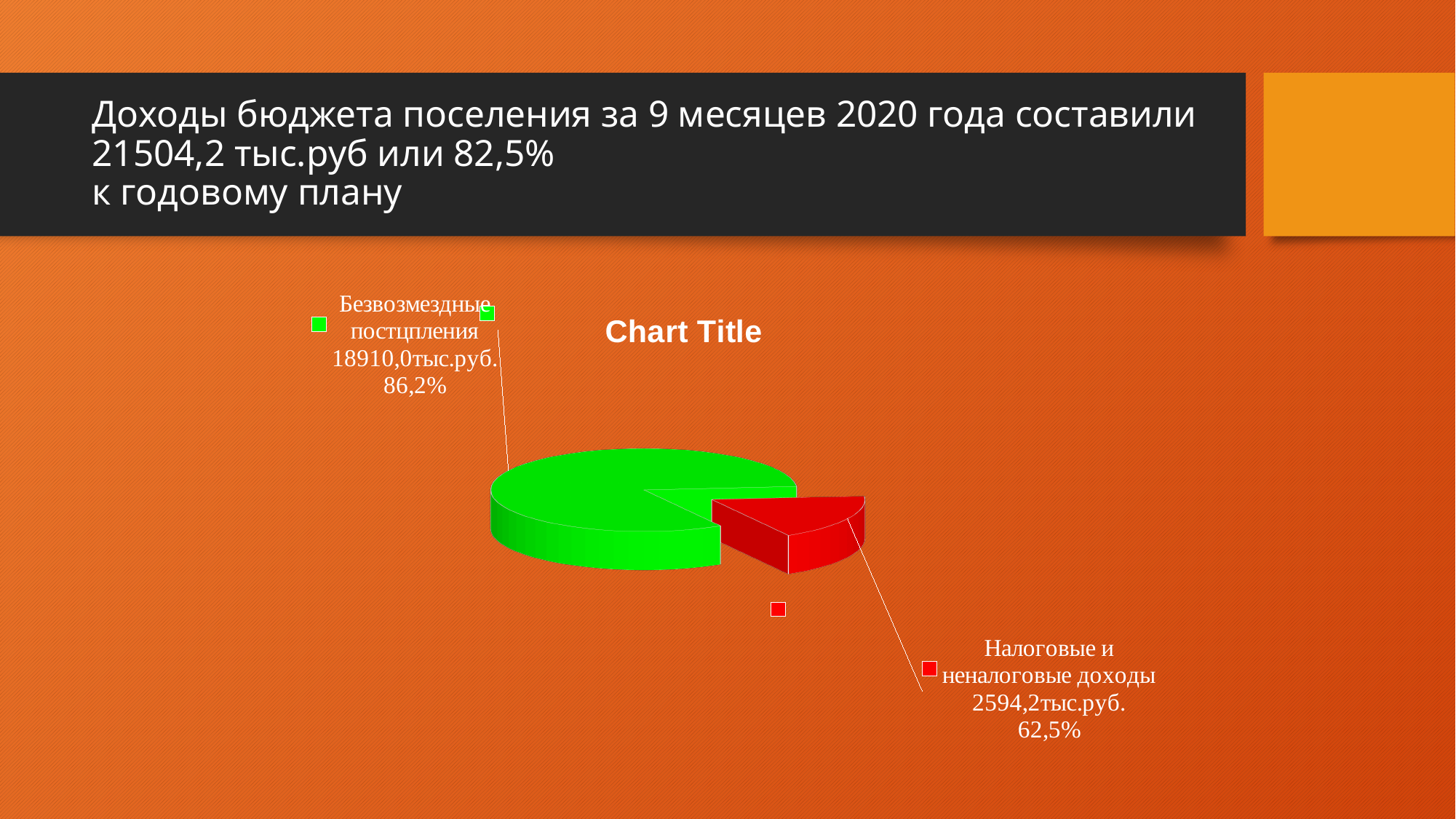
What colour is the Налоговые и неналоговые доходы slice? Red Which slice of the pie chart is the largest? Безвозмездные постцпления What kind of chart is shown on the slide? Pie chart How many slices does the pie chart have? 2 What is the title shown above the pie chart? Chart Title Which slice of the pie chart is the smallest? Налоговые и неналоговые доходы What is the difference in тыс.руб. between Безвозмездные постцпления and Налоговые и неналоговые доходы? 16315,8 тыс.руб. What value in тыс.руб. is shown for Безвозмездные постцпления? 18910,0тыс.руб. What value in тыс.руб. is shown for Налоговые и неналоговые доходы? 2594,2тыс.руб. What percentage is printed next to the Безвозмездные постцпления slice? 86,2% What percentage is printed next to the Налоговые и неналоговые доходы slice? 62,5% Which is larger: Безвозмездные постцпления or Налоговые и неналоговые доходы? Безвозмездные постцпления